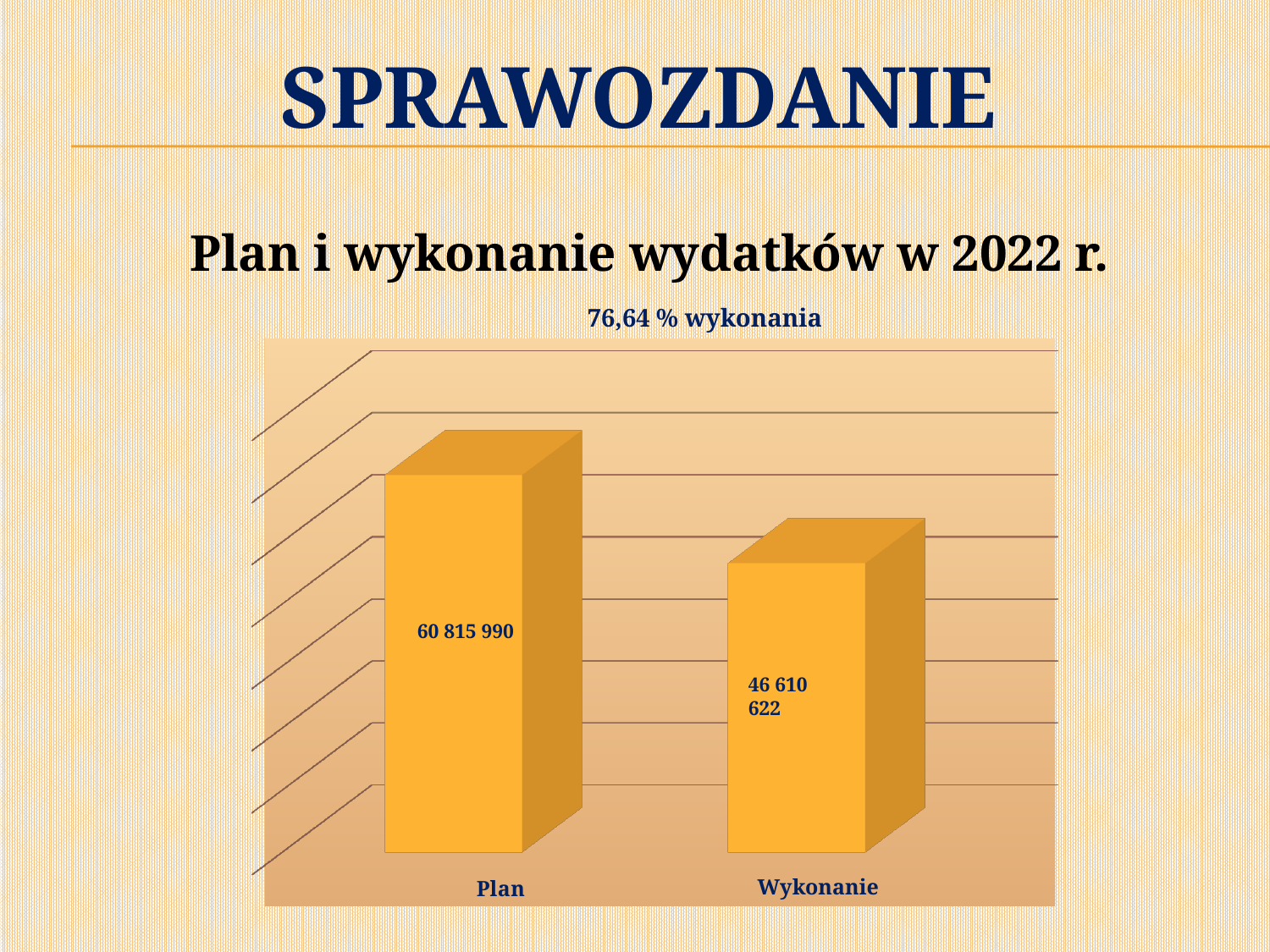
How many bars are shown in the chart? 2 What kind of chart is shown on the slide? Bar chart Which is larger, the Plan value or the Wykonanie value? Plan Which category has the highest value? Plan Which category has the lowest value? Wykonanie What is the difference between the Plan value and the Wykonanie value? 14 205 368 What percentage of execution (wykonania) is stated above the chart? 76,64 % What is the value of the Plan bar? 60 815 990 What is the value of the Wykonanie bar? 46 610 622